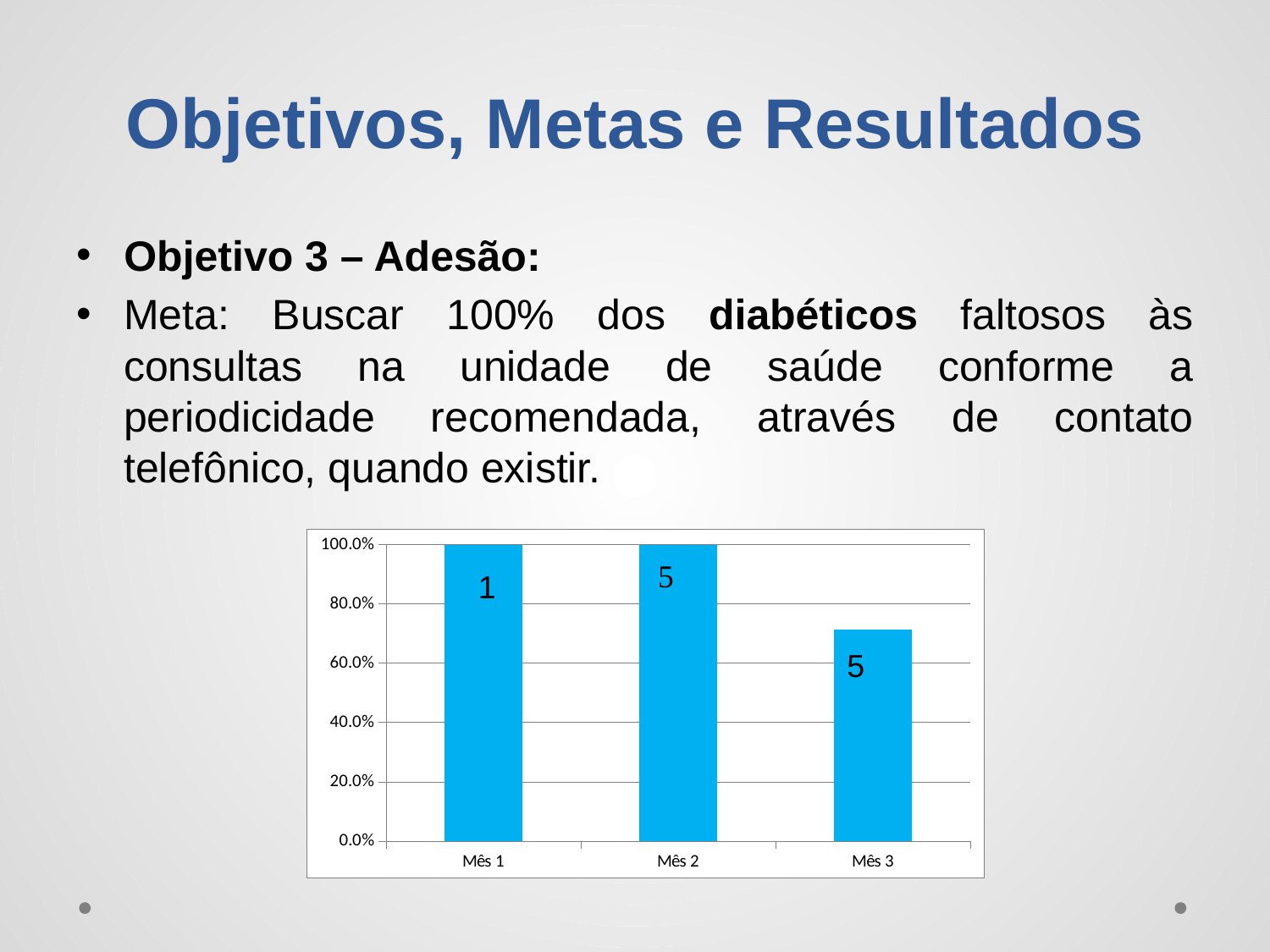
What data label is printed on the bar for Mês 1? 1 What kind of chart is shown on the slide? bar chart What value does the bar for Mês 1 reach on the y axis? 100.0% Is the value for Mês 3 greater or less than 80.0%? less Is the value for Mês 3 greater or less than 60.0%? greater What data label is printed on the bar for Mês 3? 5 What colour are the bars in the chart? blue Which is larger, the value for Mês 1 or the value for Mês 3? Mês 1 Does the value rise or fall from Mês 2 to Mês 3? fall How many categories are shown on the x axis of the chart? 3 What value does the bar for Mês 2 reach on the y axis? 100.0% Which category has the lowest bar? Mês 3